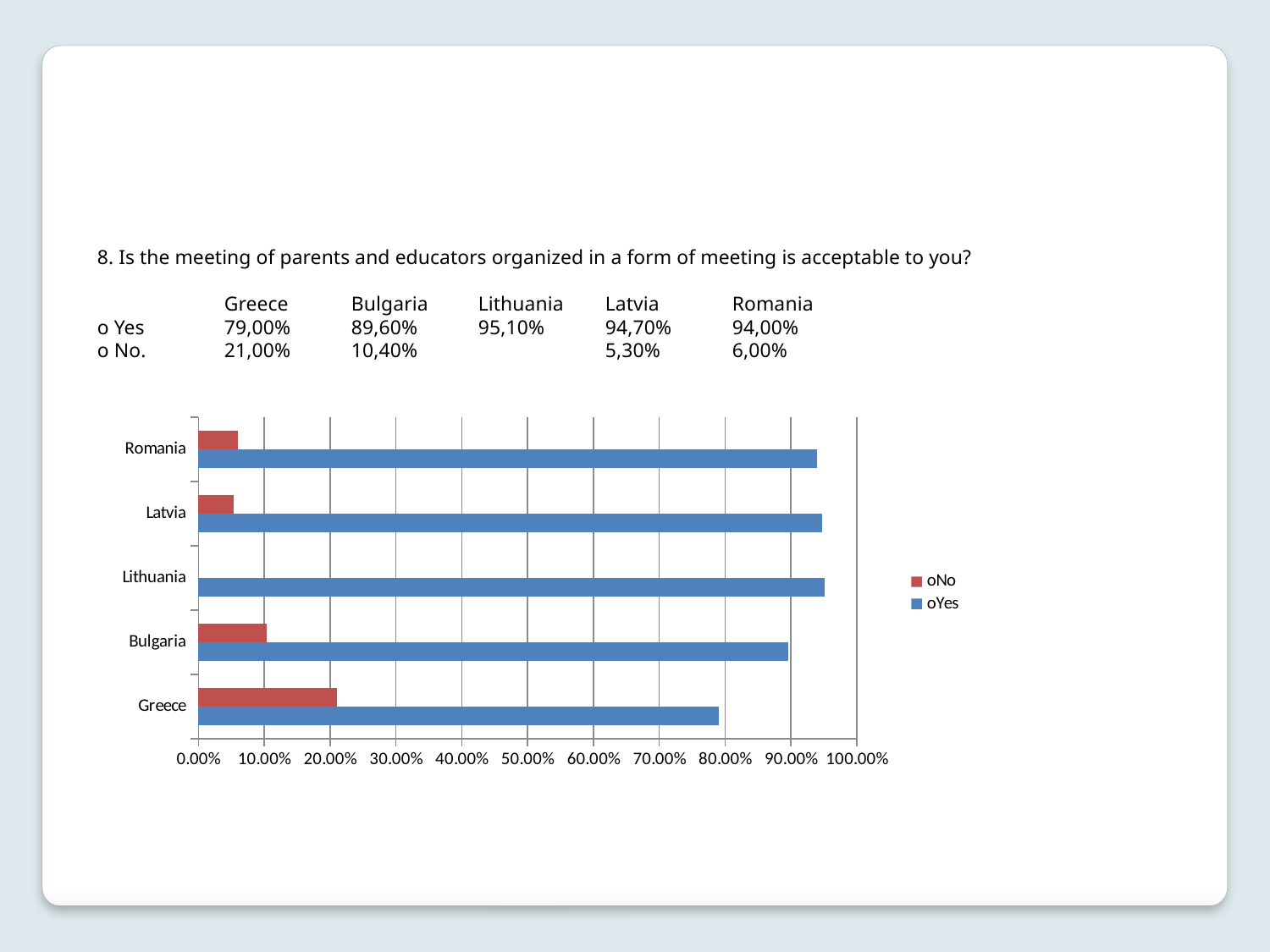
How many series does the chart legend list? 2 What is the Yes value for Lithuania? 95,10% Which country has the highest Yes value? Lithuania What type of chart is shown on the slide? bar chart Which country has the lowest Yes value? Greece Which is larger, the No value for Latvia or the No value for Romania? Romania What is the Yes value for Greece? 79,00% What is the No value for Bulgaria? 10,40% Is the Yes value for Romania greater or less than 90.00%? greater What is the difference between the Yes values for Bulgaria and Greece? 10,60% How many countries are shown on the chart's vertical axis? 5 Which country has the largest No value? Greece